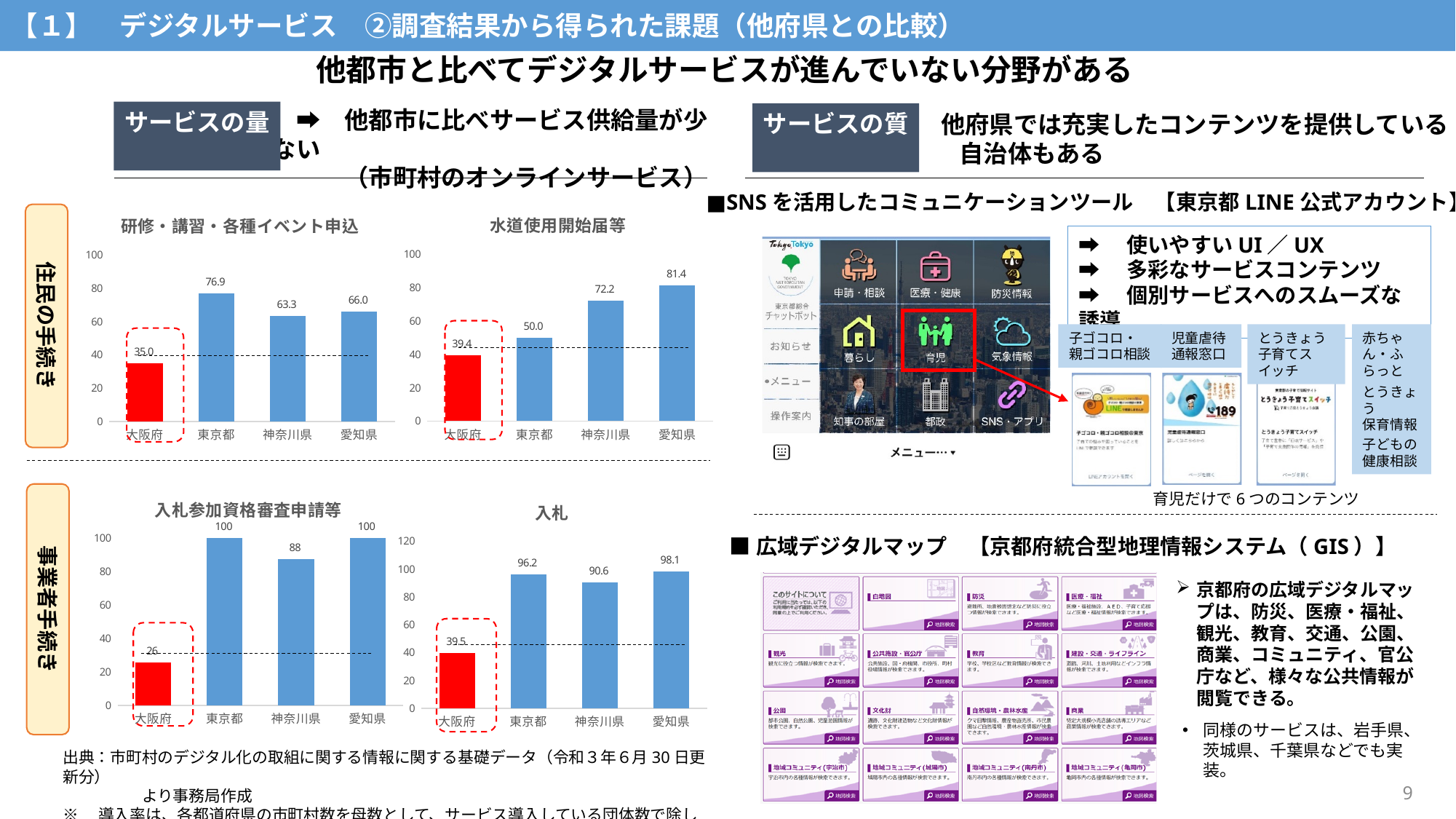
In the chart titled 水道使用開始届等, what is the difference between the values for 愛知県 and 大阪府? 42.0 In the chart titled 研修・講習・各種イベント申込, which prefecture has the lowest value? 大阪府 In the chart titled 入札, which prefecture has the highest value? 愛知県 In the chart titled 入札参加資格審査申請等, what is the value for 大阪府? 26 In the chart titled 水道使用開始届等, which is larger, the value for 東京都 or the value for 神奈川県? 神奈川県 In the chart titled 研修・講習・各種イベント申込, what is the value for 東京都? 76.9 In the chart titled 入札, what is the difference between the values for 東京都 and 神奈川県? 5.6 What kind of chart is the chart titled 入札? bar chart In the chart titled 入札参加資格審査申請等, what is the value for 神奈川県? 88 How many prefectures are shown in the chart titled 研修・講習・各種イベント申込? 4 In the chart titled 水道使用開始届等, what is the value for 愛知県? 81.4 In the chart titled 入札, is the value for 大阪府 greater or less than 40? less